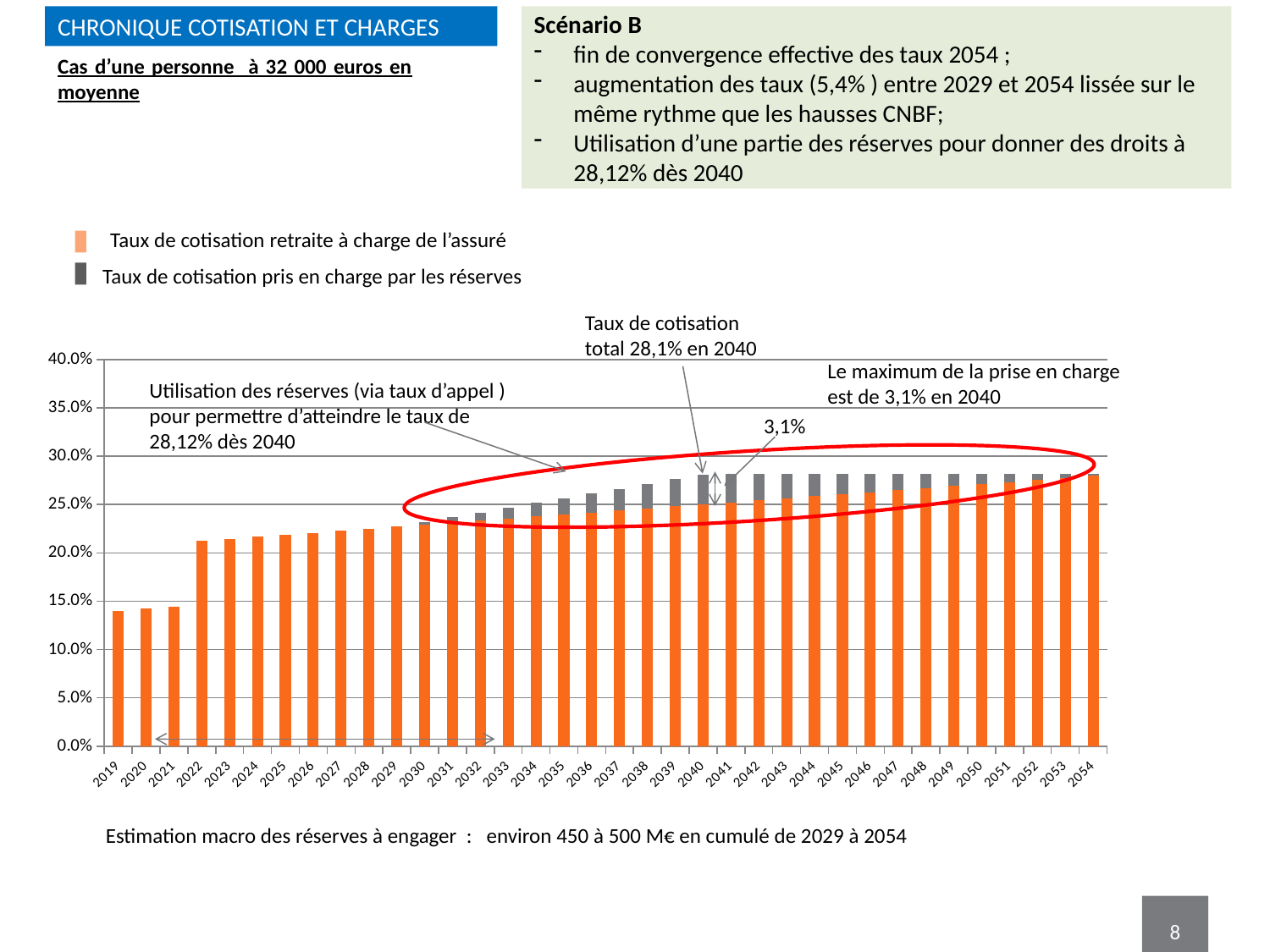
Do the total bar values generally rise or fall from 2019 to 2054? rise Is the total value for 2022 greater or less than 20%? greater According to the annotation on the chart, what is the maximum share taken on by the reserves in 2040? 3,1% What kind of chart is shown on the slide? bar chart According to the annotation on the chart, what is the total contribution rate (taux de cotisation total) in 2040? 28,1% Which year has the larger total bar, 2021 or 2022? 2022 Is the total value for 2019 greater or less than 15%? less How many years are shown along the x axis of the chart? 36 Is the total value for 2054 greater or less than 25%? greater How many series does the chart's legend list? 2 Which colour represents 'Taux de cotisation pris en charge par les réserves' in the legend? grey Which year has the larger total bar, 2019 or 2054? 2054